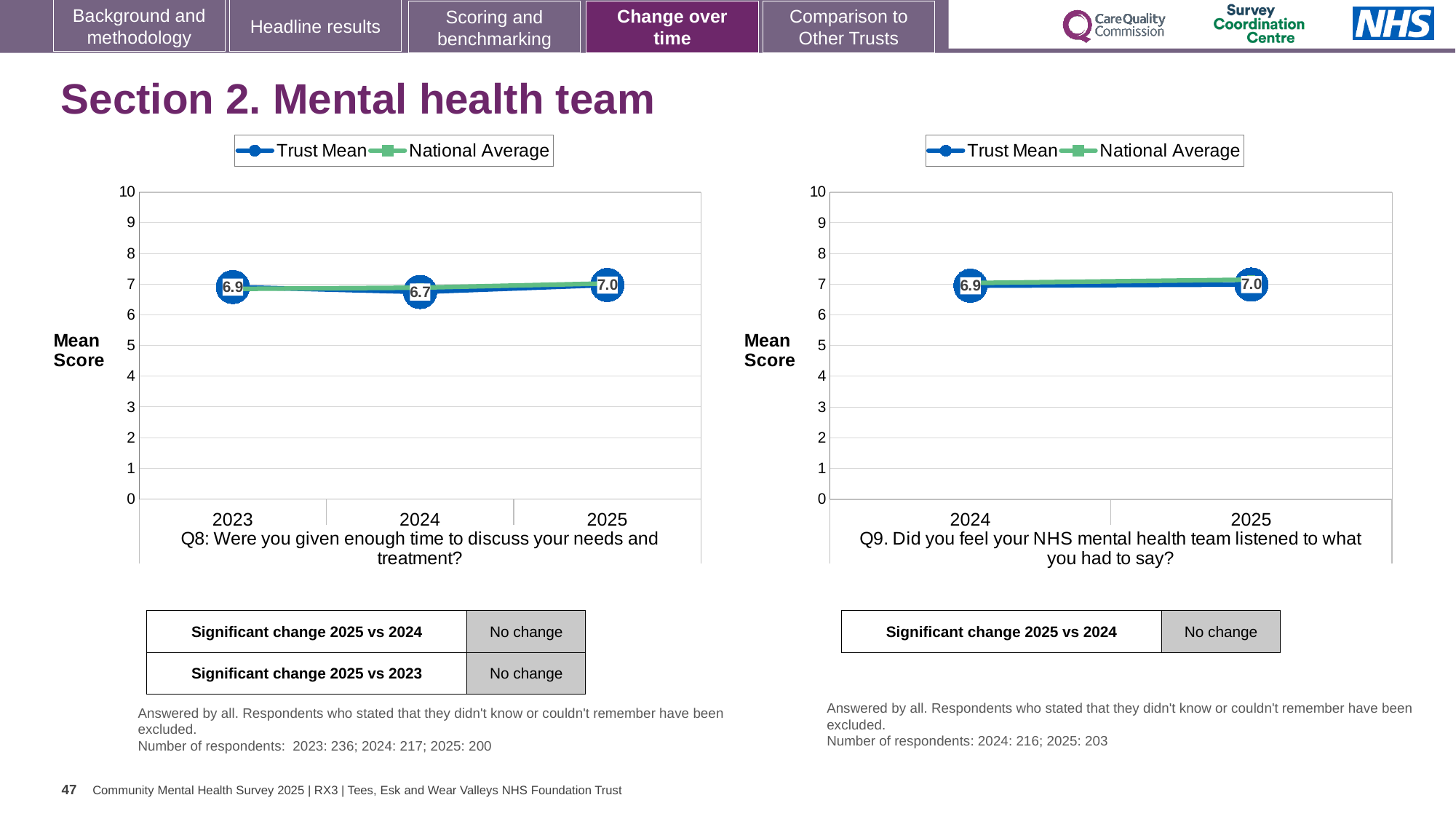
On the Q9 chart (right), is the Trust Mean score higher in 2024 or 2025? 2025 On the Q8 chart (left), which year has the lowest Trust Mean score? 2024 On the Q8 chart (left), what is the Trust Mean score for 2024? 6.7 On the Q8 chart (left), is the Trust Mean score for 2024 greater or less than 8? less How many years are shown on the x axis of the Q9 chart (right)? 2 On the Q8 chart (left), what is the Trust Mean score for 2023? 6.9 On the Q9 chart (right), what is the Trust Mean score for 2025? 7.0 On the Q9 chart (right), does the Trust Mean rise or fall from 2024 to 2025? Rise On the Q8 chart (left), which year has the highest Trust Mean score? 2025 On the Q8 chart (left), what is the difference between the Trust Mean scores for 2025 and 2024? 0.3 How many series does the legend of the Q8 chart (left) list? 2 What type of chart is used for Q8 (left)? Line chart